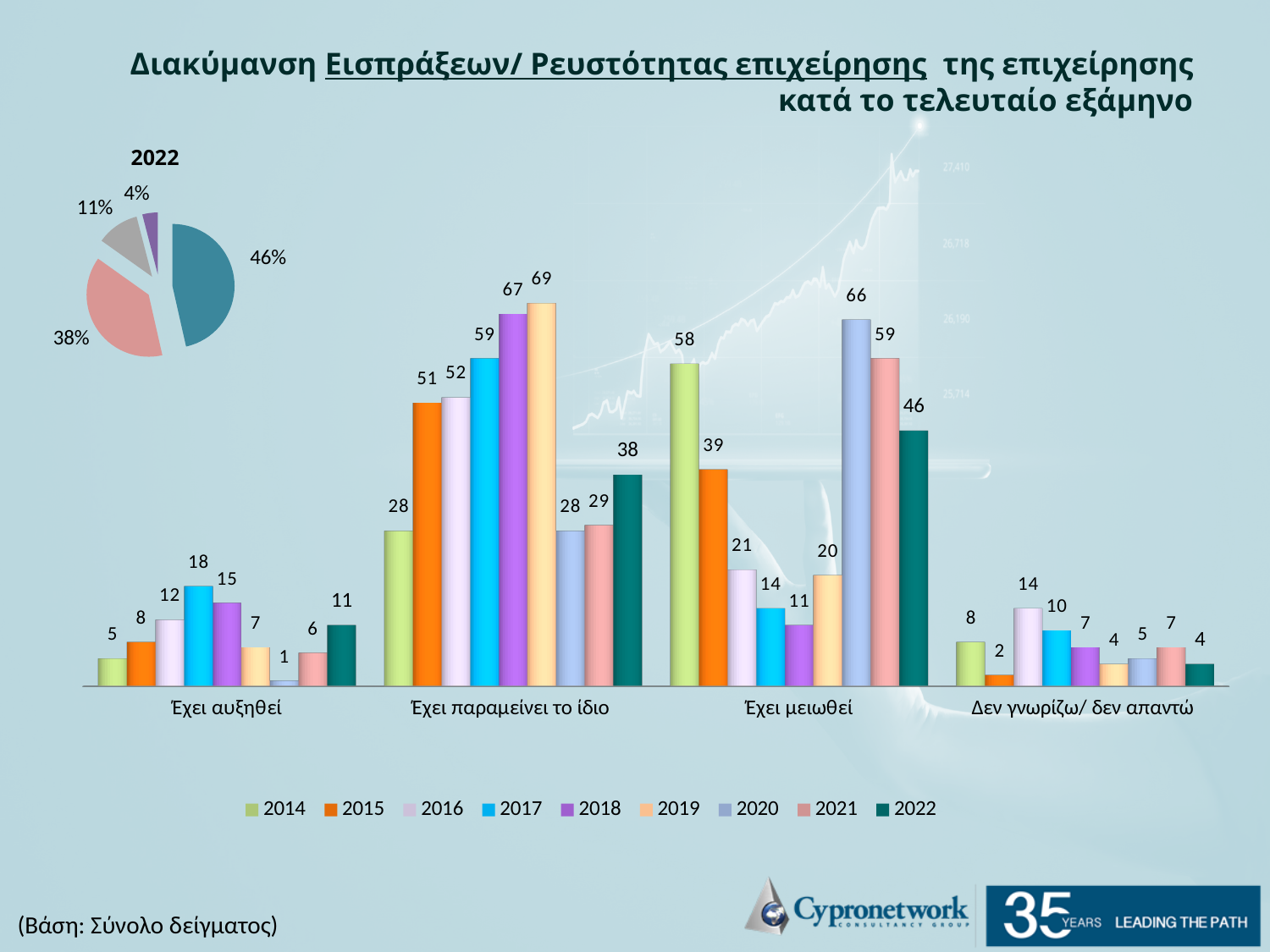
In the bar chart, which year has the lowest value in the 'Έχει αυξηθεί' category? 2020 How many categories are shown on the x axis of the bar chart? 4 In the bar chart, which is larger in the 'Δεν γνωρίζω/ δεν απαντώ' category: the value for 2016 or the value for 2017? 2016 How many series does the legend of the bar chart list? 9 What kind of chart is the large chart on the slide? bar chart In the bar chart, what is the value for 2020 in the 'Έχει μειωθεί' category? 66 In the bar chart, which year has the highest value in the 'Έχει παραμείνει το ίδιο' category? 2019 In the bar chart, what is the value for 2022 in the 'Έχει παραμείνει το ίδιο' category? 38 In the bar chart, what is the difference between the 2020 and 2022 values in the 'Έχει μειωθεί' category? 20 In the bar chart, what is the value for 2017 in the 'Έχει αυξηθεί' category? 18 In the pie chart labelled 2022, what is the share of the largest slice? 46% In the pie chart labelled 2022, what is the share of the smallest slice? 4%